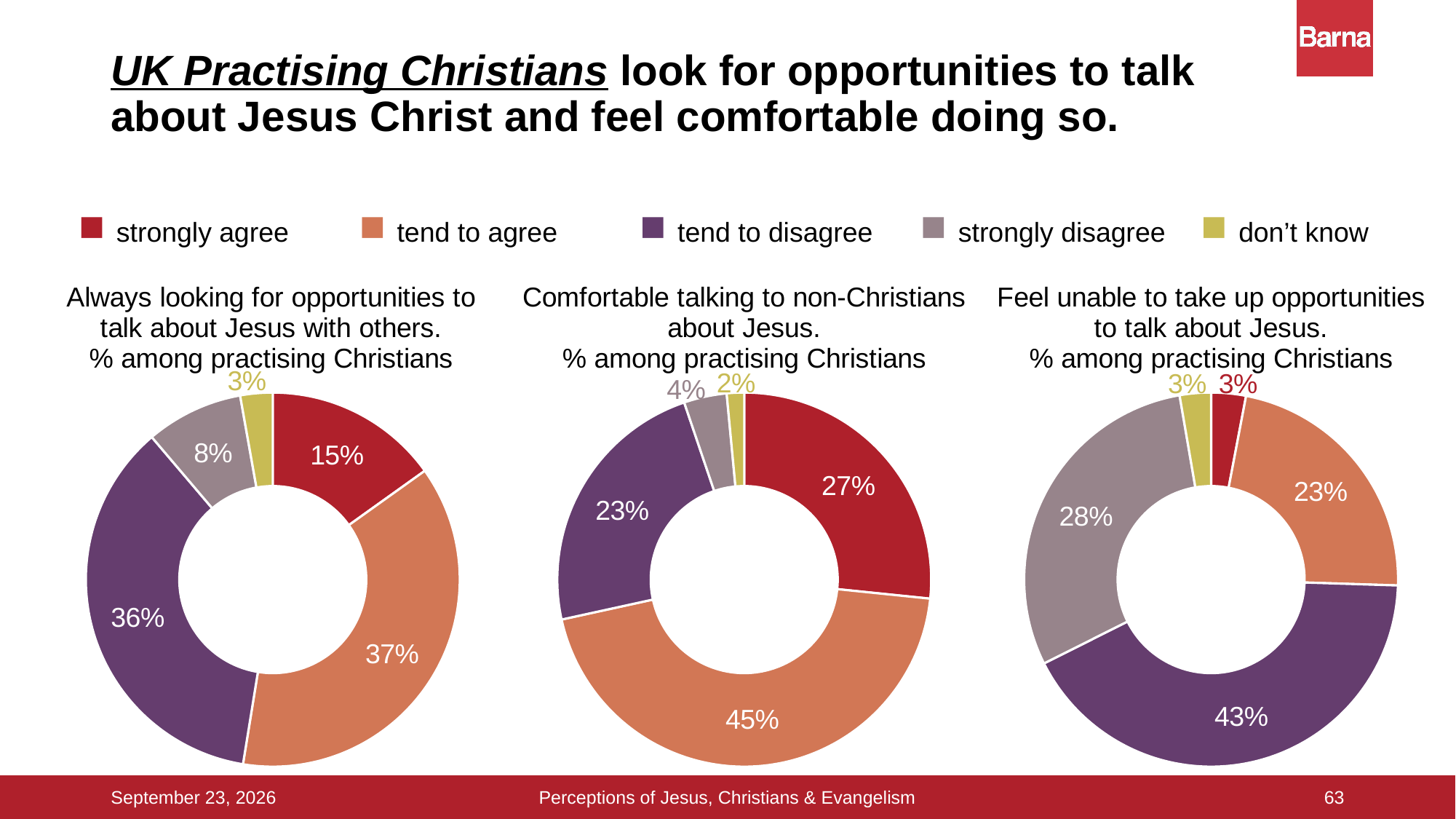
In the 'Comfortable talking to non-Christians about Jesus' chart, which is larger: 'tend to agree' or 'tend to disagree'? tend to agree What kind of chart is used on this slide? Donut (pie) chart Which colour represents 'strongly disagree' in the legend? Grey (mauve-grey) How many charts are shown on the slide? 3 How many series does the legend list? 5 In the 'Feel unable to take up opportunities to talk about Jesus' chart, what percentage strongly disagree? 28% In the 'Feel unable to take up opportunities to talk about Jesus' chart, what is the combined share of 'strongly agree' and 'tend to agree'? 26% In the 'Comfortable talking to non-Christians about Jesus' chart, which response has the smallest share? don't know In the 'Feel unable to take up opportunities to talk about Jesus' chart, which response has the largest share? tend to disagree In the 'Comfortable talking to non-Christians about Jesus' chart, what percentage strongly agree? 27% In the 'Always looking for opportunities to talk about Jesus with others' chart, what is the difference between the 'tend to agree' and 'strongly agree' shares? 22% In the 'Always looking for opportunities to talk about Jesus with others' chart, what percentage tend to agree? 37%